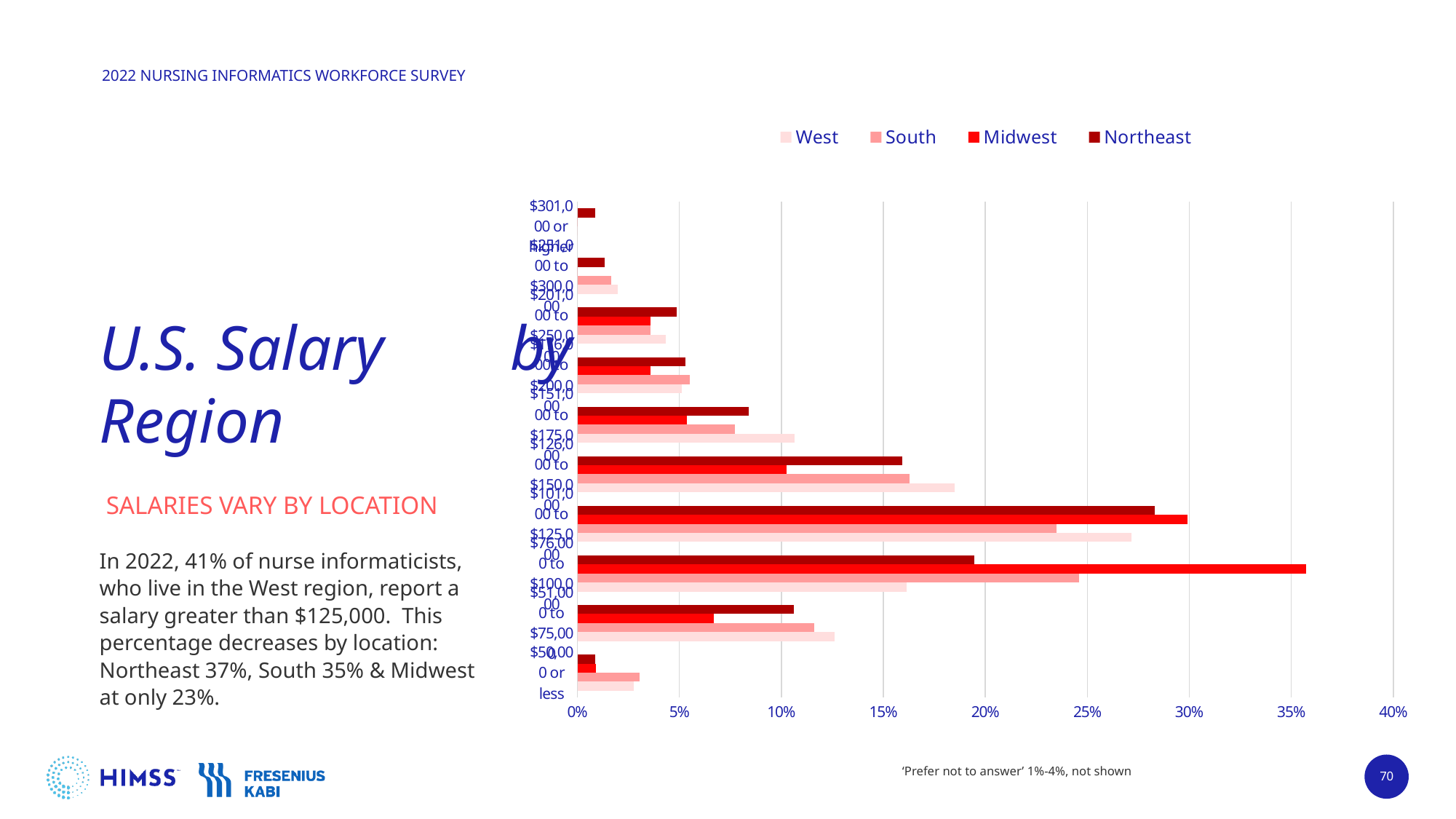
Which region has the single longest bar on the chart? Midwest Is the West value for '$50,000 or less' greater or less than 5%? less Is the Northeast value for '$101,000 to $125,000' greater or less than 25%? greater What kind of chart is shown on the slide? Bar chart How many salary categories (bar groups) are plotted on the chart? 10 Which region is the only one with a visible bar in the '$301,000 or higher' category? Northeast Is the Northeast value for '$301,000 or higher' greater or less than 5%? less What is the highest value shown on the horizontal axis? 40% Which regions are listed in the chart legend? West, South, Midwest, Northeast For the '$50,000 or less' category, which is larger: the South bar or the Northeast bar? South How many series does the legend list? 4